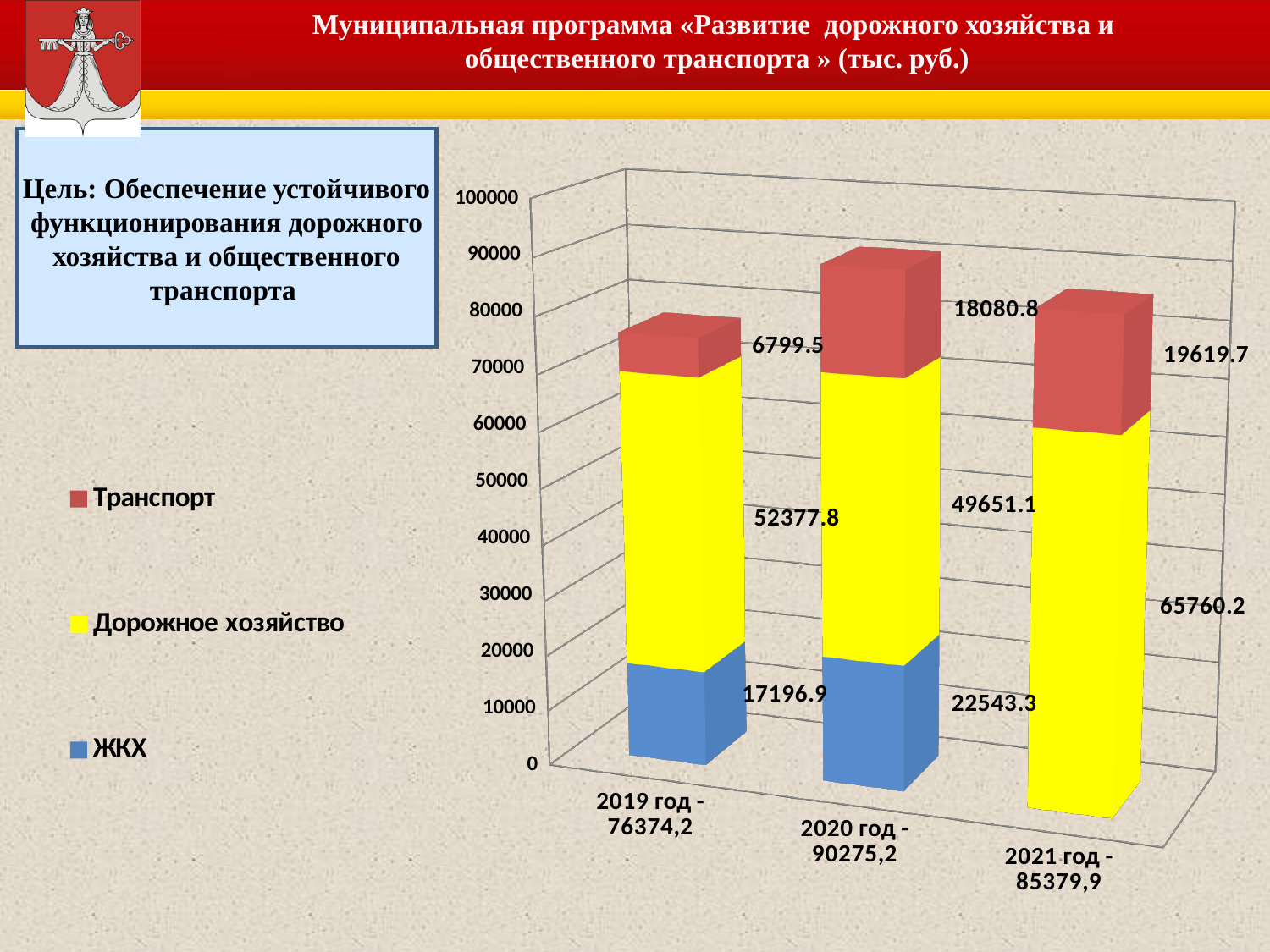
What is the difference between the ЖКХ values for 2020 and 2019? 5346.4 Which series is shown in yellow in the legend? Дорожное хозяйство Which is larger, the Транспорт value in 2021 or in 2020? 2021 In which year is the Транспорт value the lowest? 2019 What type of chart is shown on the slide? stacked bar chart In which year is the Дорожное хозяйство value the highest? 2021 How many year categories are shown on the x axis? 3 What is the value for Дорожное хозяйство in 2019? 52377.8 What is the value for Транспорт in 2020? 18080.8 How many series does the legend list? 3 What is the value for Дорожное хозяйство in 2021? 65760.2 What is the value for ЖКХ in 2020? 22543.3